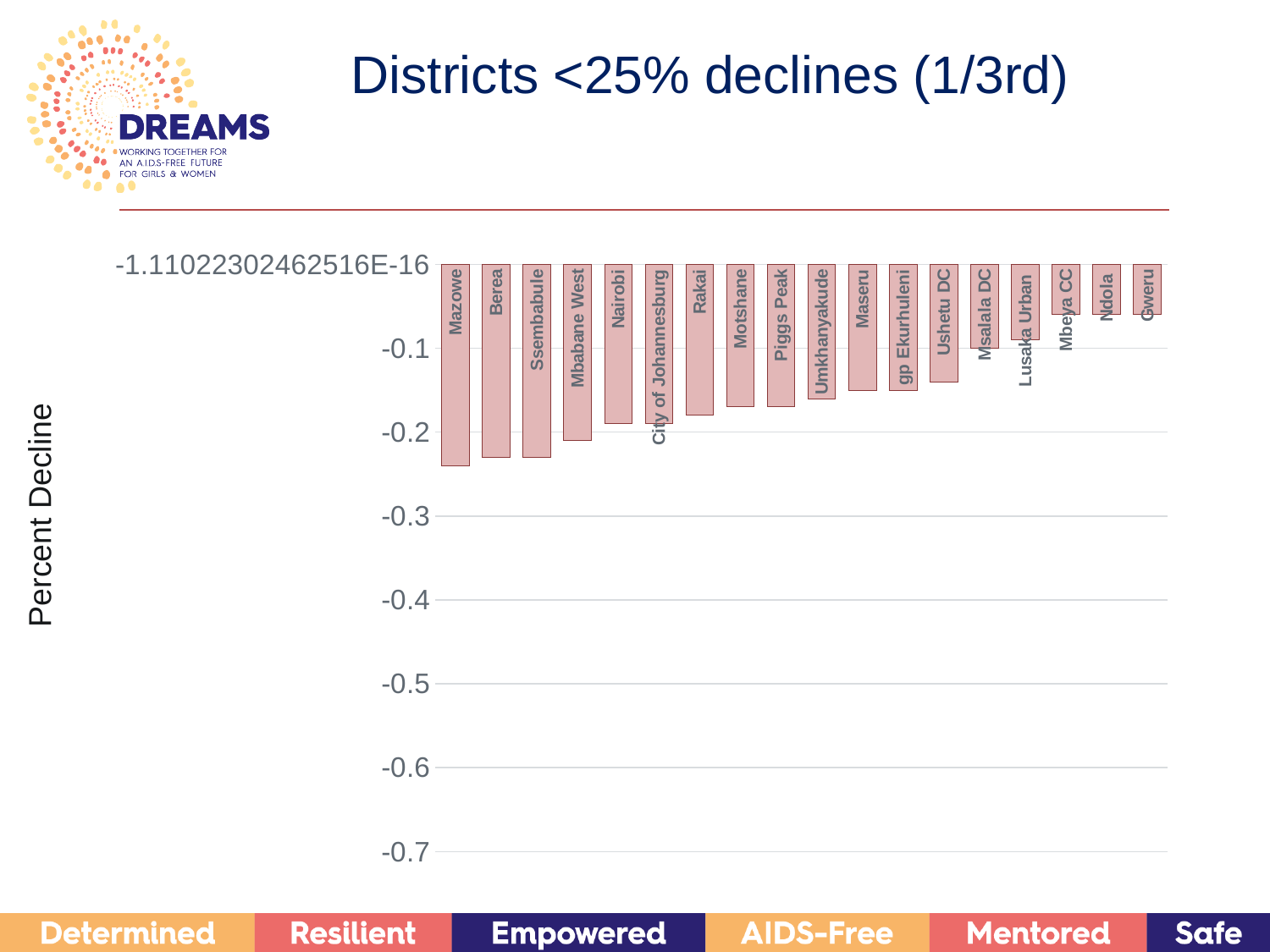
Do the values rise or fall moving from left to right across the districts? rise What is the label on the vertical axis of the chart? Percent Decline What kind of chart is shown on the slide? bar chart Is the value for Mazowe greater or less than -0.2? less How many districts are plotted in the chart? 18 What is the title of the chart? Districts <25% declines (1/3rd) Is the value for Gweru greater or less than -0.1? greater Is the value for Motshane greater or less than -0.2? greater Which has the larger (less negative) value, Nairobi or Ndola? Ndola Which has the larger (less negative) value, Mazowe or Gweru? Gweru